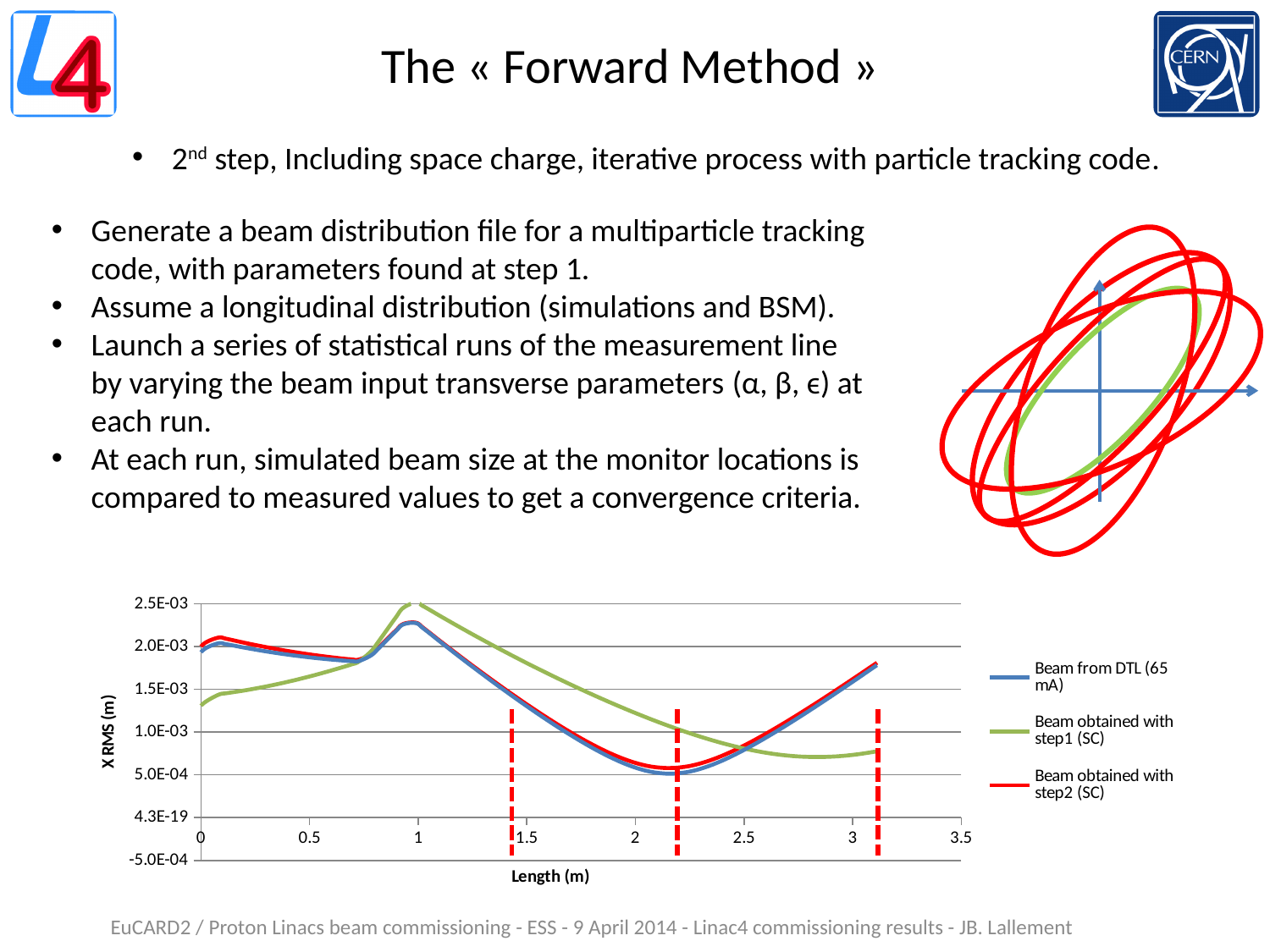
How many series does the legend of the chart list? 3 Between Length 1 m and Length 2 m, does the 'Beam from DTL (65 mA)' series rise or fall? fall What kind of chart is shown at the bottom of the slide? line chart At Length 3 m, is the value of the 'Beam obtained with step1 (SC)' series greater or less than 1.0E-03? less Between Length 2.5 m and Length 3 m, does the 'Beam obtained with step2 (SC)' series rise or fall? rise What is the title of the y axis of the chart? X RMS (m) At Length 0 m, which series has the larger value: 'Beam from DTL (65 mA)' or 'Beam obtained with step1 (SC)'? Beam from DTL (65 mA) At Length 0 m, is the value of the 'Beam obtained with step1 (SC)' series greater or less than 1.0E-03? greater At Length 2 m, which series has the larger value: 'Beam obtained with step1 (SC)' or 'Beam from DTL (65 mA)'? Beam obtained with step1 (SC) At Length 0 m, is the value of the 'Beam from DTL (65 mA)' series greater or less than 1.5E-03? greater What is the title of the x axis of the chart? Length (m)